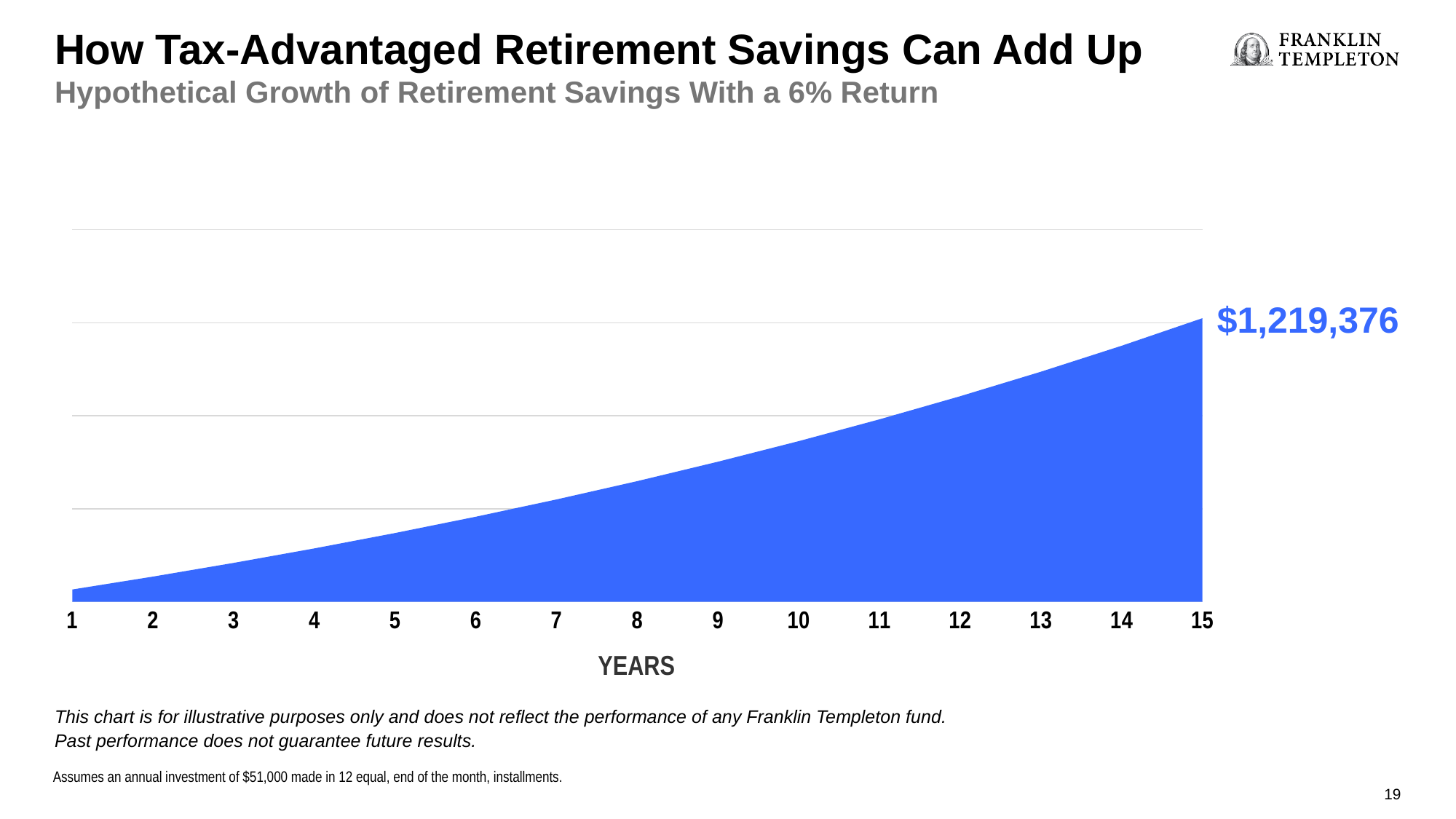
What is the subtitle of the chart? Hypothetical Growth of Retirement Savings With a 6% Return How many years are shown along the x axis? 15 Do the values rise or fall as the years increase from 1 to 15? rise Which is larger, the value at year 5 or the value at year 10? year 10 Which is larger, the value at year 12 or the value at year 3? year 12 Which year has the lowest value? 1 What is the value shown at year 15? $1,219,376 What kind of chart is shown on the slide? area chart What is the label on the x axis? YEARS Which year has the highest value? 15